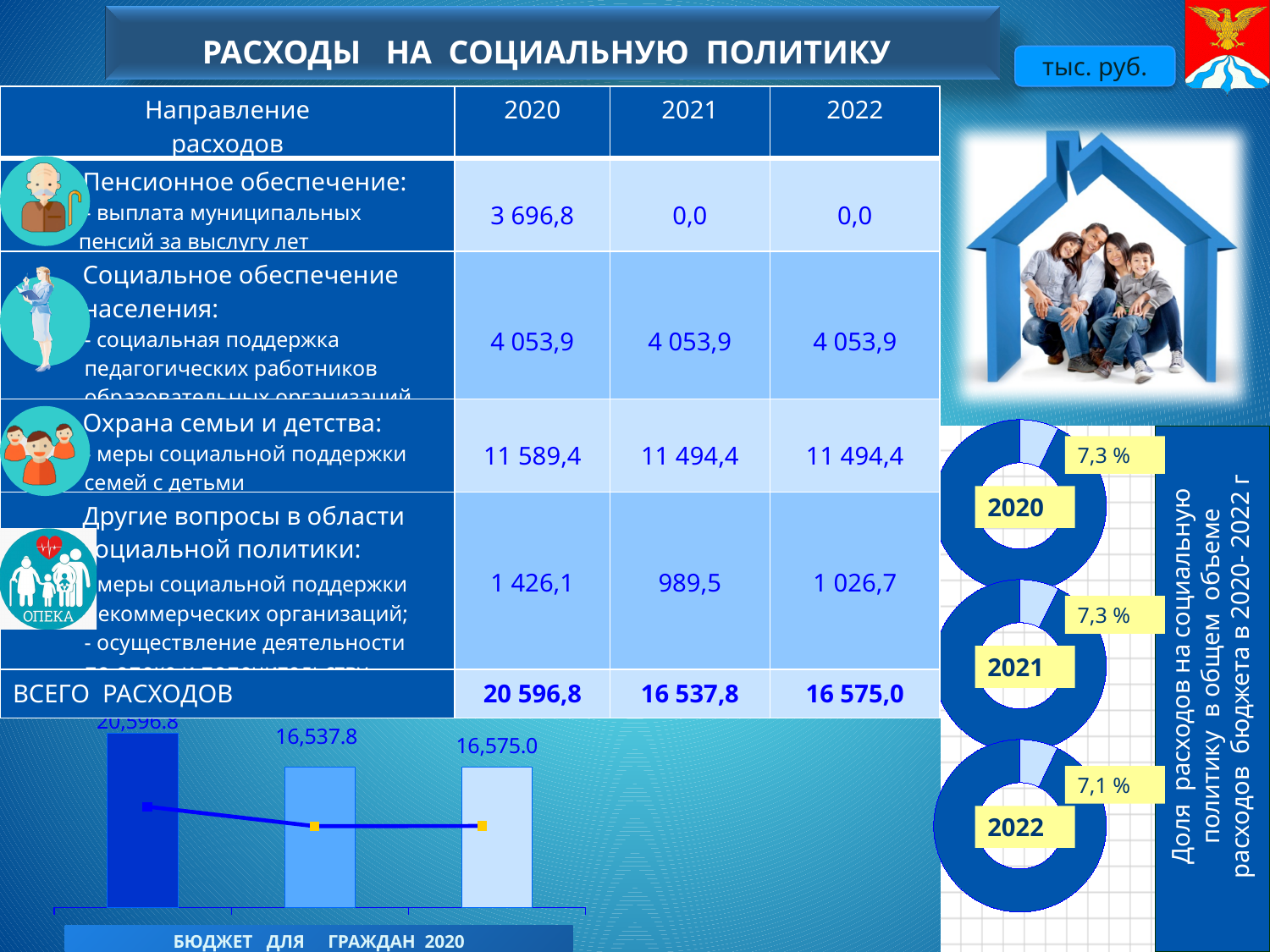
In the donut charts on the right of the slide, which year shows the lowest share? 2022 In the bar chart at the bottom left of the slide, do the values rise or fall from the first bar to the second bar? Fall In the bar chart at the bottom left of the slide, which is larger: the first bar or the third bar? The first bar (20,596.8) In the bar chart at the bottom left of the slide, what value is labelled on the first (leftmost) bar? 20,596.8 In the bar chart at the bottom left of the slide, what value is labelled on the second (middle) bar? 16,537.8 In the bar chart at the bottom left of the slide, which bar has the highest value? The first (leftmost) bar, 20,596.8 In the bar chart at the bottom left of the slide, what value is labelled on the third (rightmost) bar? 16,575.0 In the bar chart at the bottom left of the slide, what is the difference between the first bar (20,596.8) and the second bar (16,537.8)? 4,059.0 How many bars are plotted in the bar chart at the bottom left of the slide? 3 What kind of chart is shown at the bottom left of the slide? Bar chart (with a line overlay) In the donut charts on the right of the slide, what share is shown for 2022? 7,1 % In the bar chart at the bottom left of the slide, what is the difference between the third bar (16,575.0) and the second bar (16,537.8)? 37.2